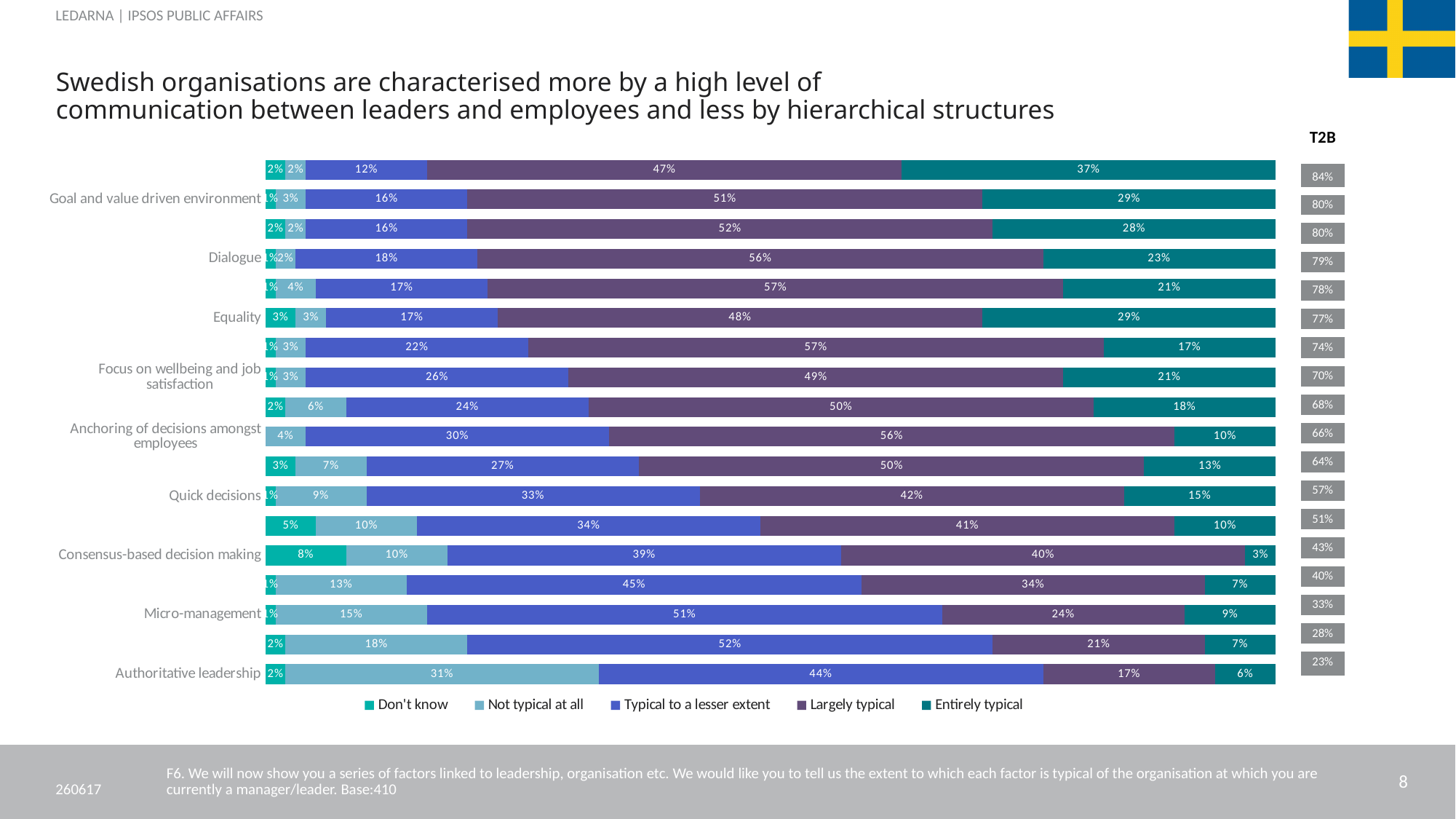
What is the 'Entirely typical' value for Equality? 29% What is the T2B value shown for Authoritative leadership? 23% What are the legend entries of the chart? Don't know, Not typical at all, Typical to a lesser extent, Largely typical, Entirely typical For Anchoring of decisions amongst employees, what is the difference between the 'Largely typical' and 'Entirely typical' values? 46 percentage points Which labelled category has the highest 'Not typical at all' value? Authoritative leadership For Quick decisions, which is larger: 'Largely typical' or 'Entirely typical'? Largely typical What is the 'Don't know' value for Consensus-based decision making? 8% What is the 'Largely typical' value for Dialogue? 56% What is the 'Typical to a lesser extent' value for Micro-management? 51% How many series does the legend list? 5 What kind of chart is shown on the slide? Stacked bar chart What is the 'Not typical at all' value for Authoritative leadership? 31%